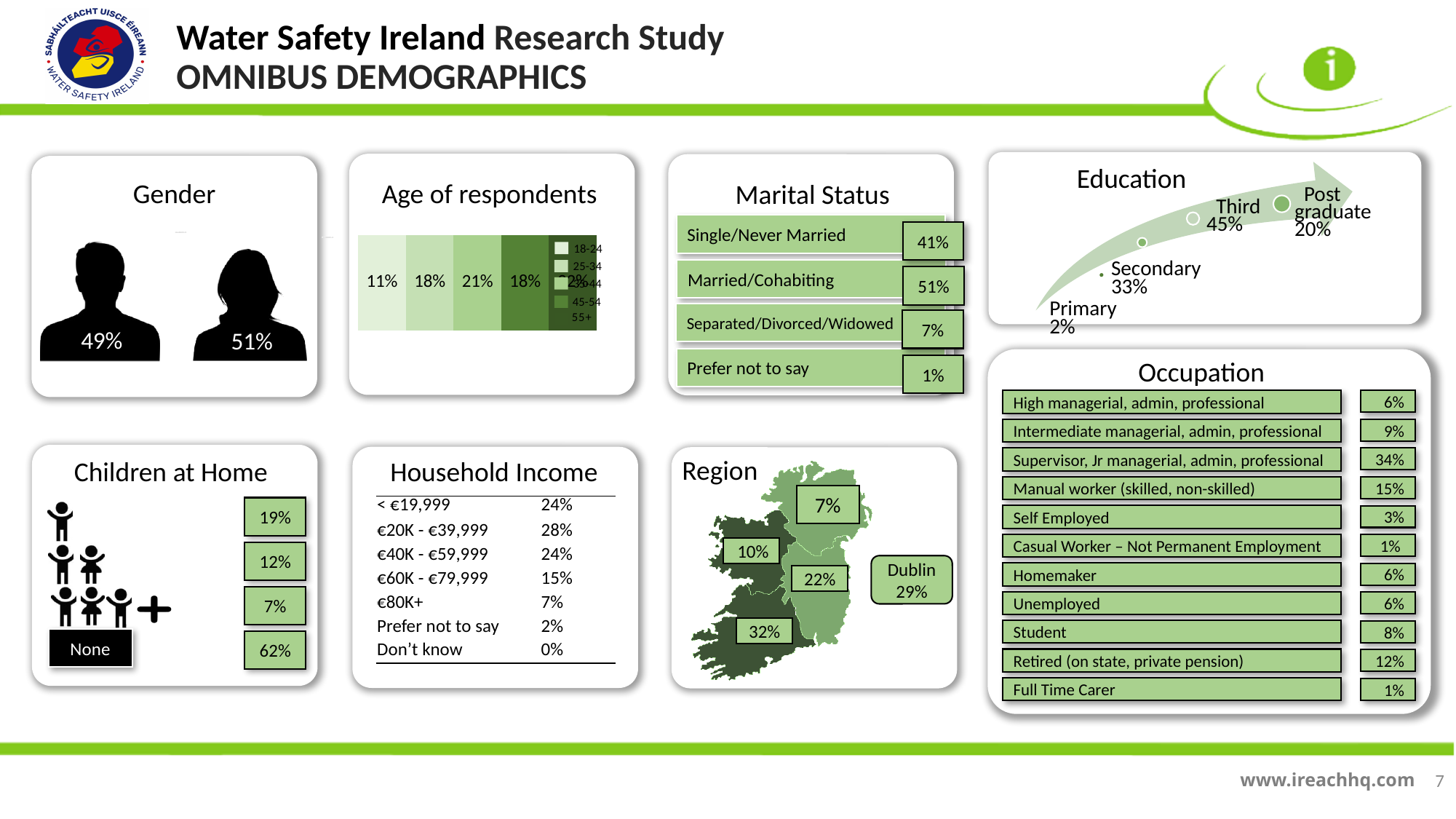
In the Occupation chart, how many occupation categories are listed? 11 In the Marital Status chart, what is the difference between Single/Never Married and Separated/Divorced/Widowed? 34% In the Marital Status chart, what percentage are Married/Cohabiting? 51% In the Age of respondents chart, how many age groups does the legend list? 5 In the Age of respondents chart, what kind of chart is shown? Stacked bar chart In the Age of respondents chart, what is the value of the third segment? 21% In the Occupation chart, what percentage are Retired (on state, private pension)? 12% In the Region chart, which region has the larger value, Dublin or the region labelled 32%? The region labelled 32% In the Occupation chart, which category has the highest value? Supervisor, Jr managerial, admin, professional In the Age of respondents chart, what is the value of the first (lightest) segment? 11% In the Education chart, what percentage have a Post graduate education? 20% In the Marital Status chart, which category has the lowest value? Prefer not to say